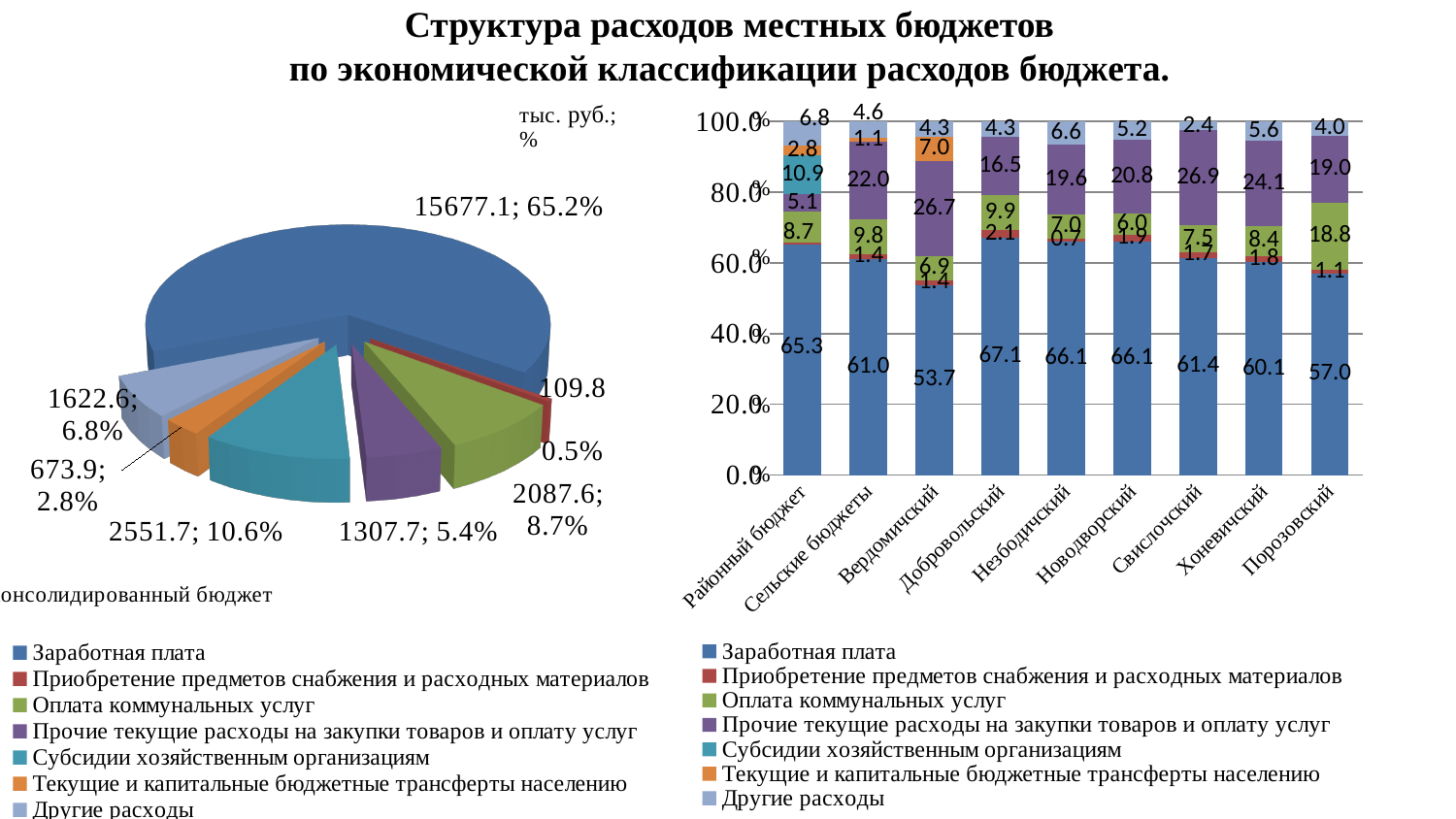
In the pie chart on the left, what value is shown for the slice labelled 2551.7? 2551.7; 10.6% In the stacked bar chart on the right, what is the value of Заработная плата for Вердомичский? 53.7 In the pie chart on the left, which slice is the smallest? Приобретение предметов снабжения и расходных материалов (109.8; 0.5%) How many categories are shown on the x axis of the stacked bar chart on the right? 9 In the stacked bar chart on the right, what is the difference between the Заработная плата values for Районный бюджет and Сельские бюджеты? 4.3 In the stacked bar chart on the right, which category has the highest value for Заработная плата? Добровольский In the stacked bar chart on the right, is the Заработная плата value for Порозовский larger or smaller than that for Хоневичский? smaller In the pie chart on the left, what share does the largest slice (Заработная плата) have? 65.2% What kind of chart is the chart on the left of the slide? pie chart In the stacked bar chart on the right, what is the value of Оплата коммунальных услуг for Порозовский? 18.8 What kind of chart is the chart on the right of the slide? stacked bar chart How many series does the legend of the stacked bar chart on the right list? 7